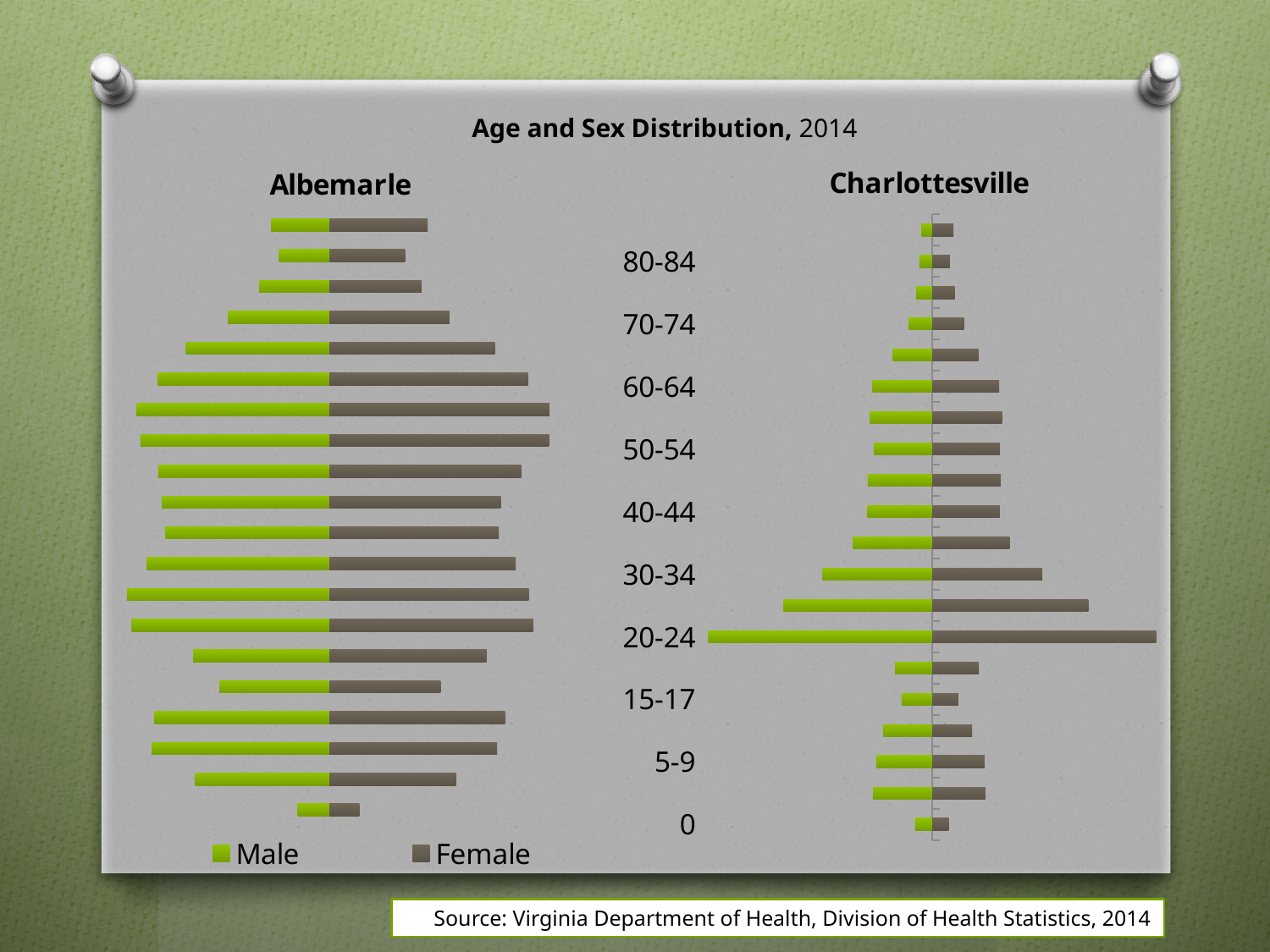
In the Albemarle chart, is the Female bar for 50-54 longer or shorter than the Female bar for 80-84? longer What kind of chart is used for the Albemarle data? bar chart How many series does the legend list? 2 In the Charlottesville chart, which age group has the longest Female bar? 20-24 In the Charlottesville chart, is the Female bar for 20-24 longer or shorter than the Female bar for 30-34? longer Which colour represents Male in the charts? green In the Charlottesville chart, is the Male bar for 60-64 longer or shorter than the Male bar for 80-84? longer In the Charlottesville chart, which age group has the longest Male bar? 20-24 What are the two series named in the legend? Male and Female